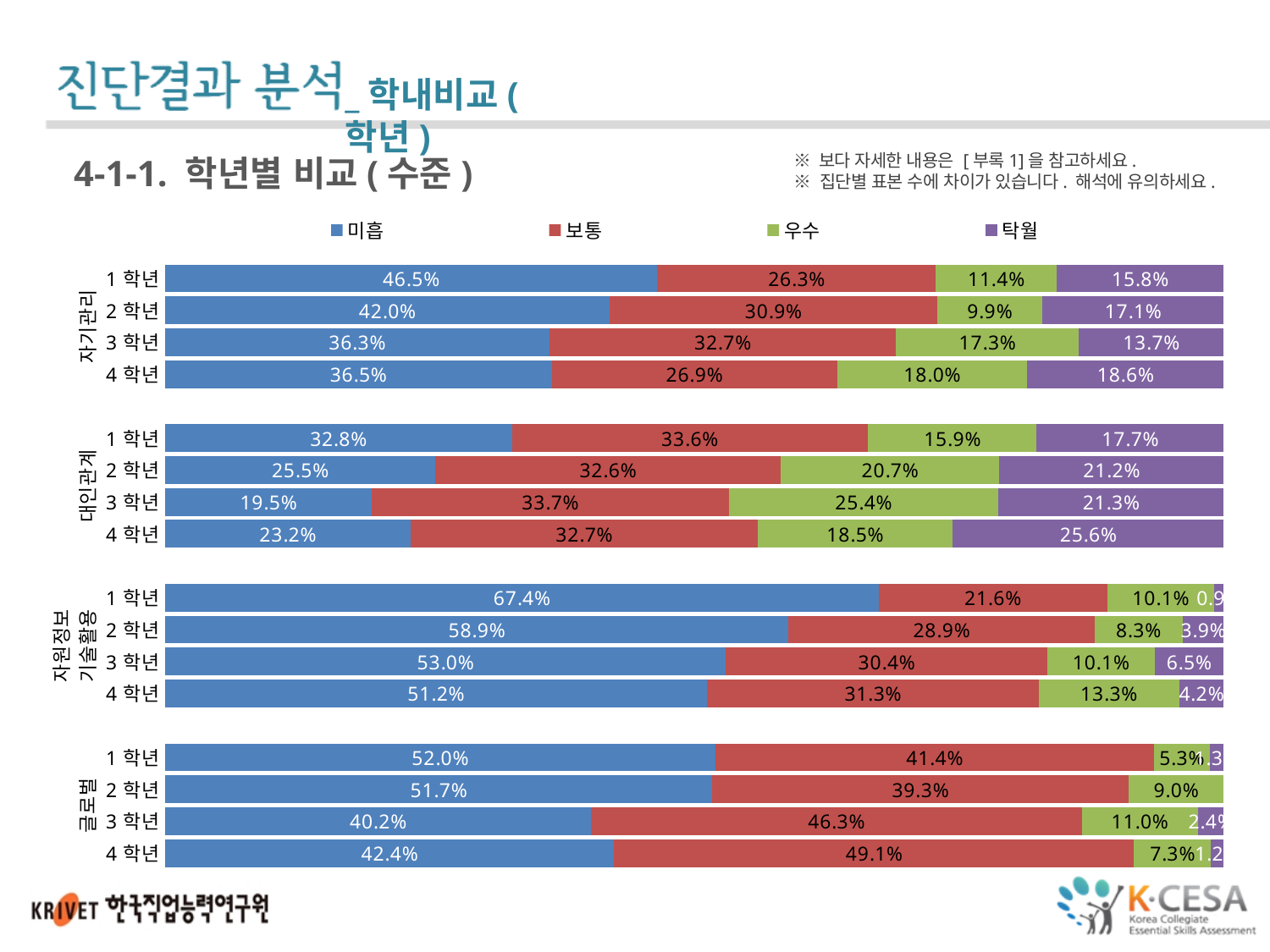
In the 자기관리 group, how much larger is the 미흡 value for 1 학년 than for 2 학년? 4.5% What is the 우수 value for 3 학년 in the 대인관계 group? 25.4% What is the 미흡 value for 1 학년 in the 자기관리 group? 46.5% How many series does the legend list? 4 What is the 보통 value for 4 학년 in the 글로벌 group? 49.1% What are the four legend entries of the chart? 미흡, 보통, 우수, 탁월 In the 대인관계 group, which grade has the lowest 미흡 value? 3 학년 In the 자기관리 group, which grade has the highest 미흡 value? 1 학년 What kind of chart is shown on the slide? Stacked bar chart In the 대인관계 group, what is the difference between the 탁월 values for 4 학년 and 1 학년? 7.9% What is the 미흡 value for 1 학년 in the 자원정보기술활용 group? 67.4% In the 글로벌 group, which grade has the larger 보통 value, 3 학년 or 4 학년? 4 학년